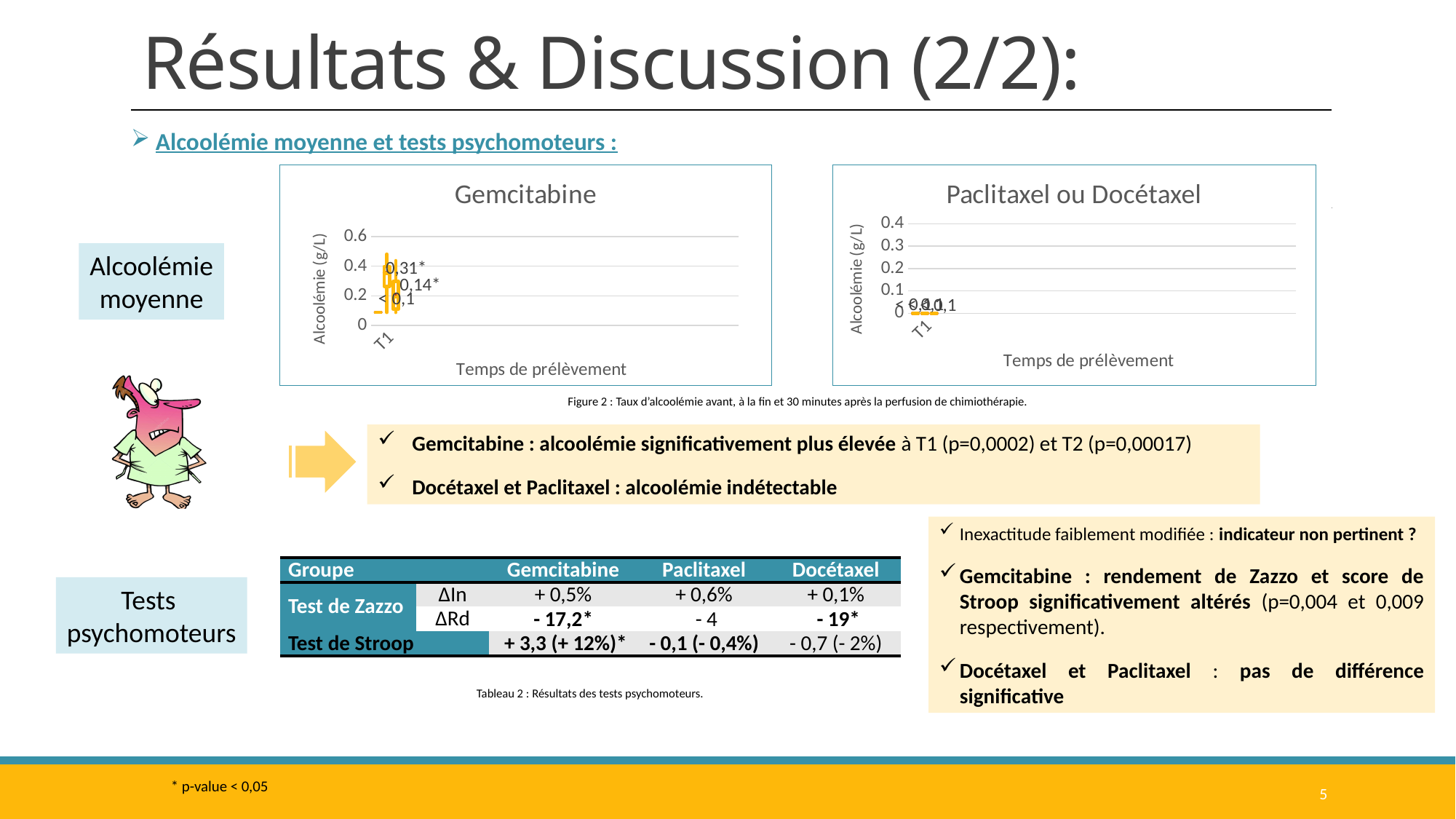
On the Gemcitabine chart, what is the highest data label shown? 0,31* On the Paclitaxel ou Docétaxel chart, is the value at T1 greater or less than 0.2? less What kind of chart is the Gemcitabine chart? bar chart On the Gemcitabine chart, what is the lowest data label shown? < 0,1 What is the title of the right chart? Paclitaxel ou Docétaxel What is the title of the left chart? Gemcitabine On the Gemcitabine chart, is the highest plotted value greater or less than 0.4? greater On the Gemcitabine chart, how many data labels are shown? 3 On the Gemcitabine chart, is the highest plotted value greater or less than 0.2? greater